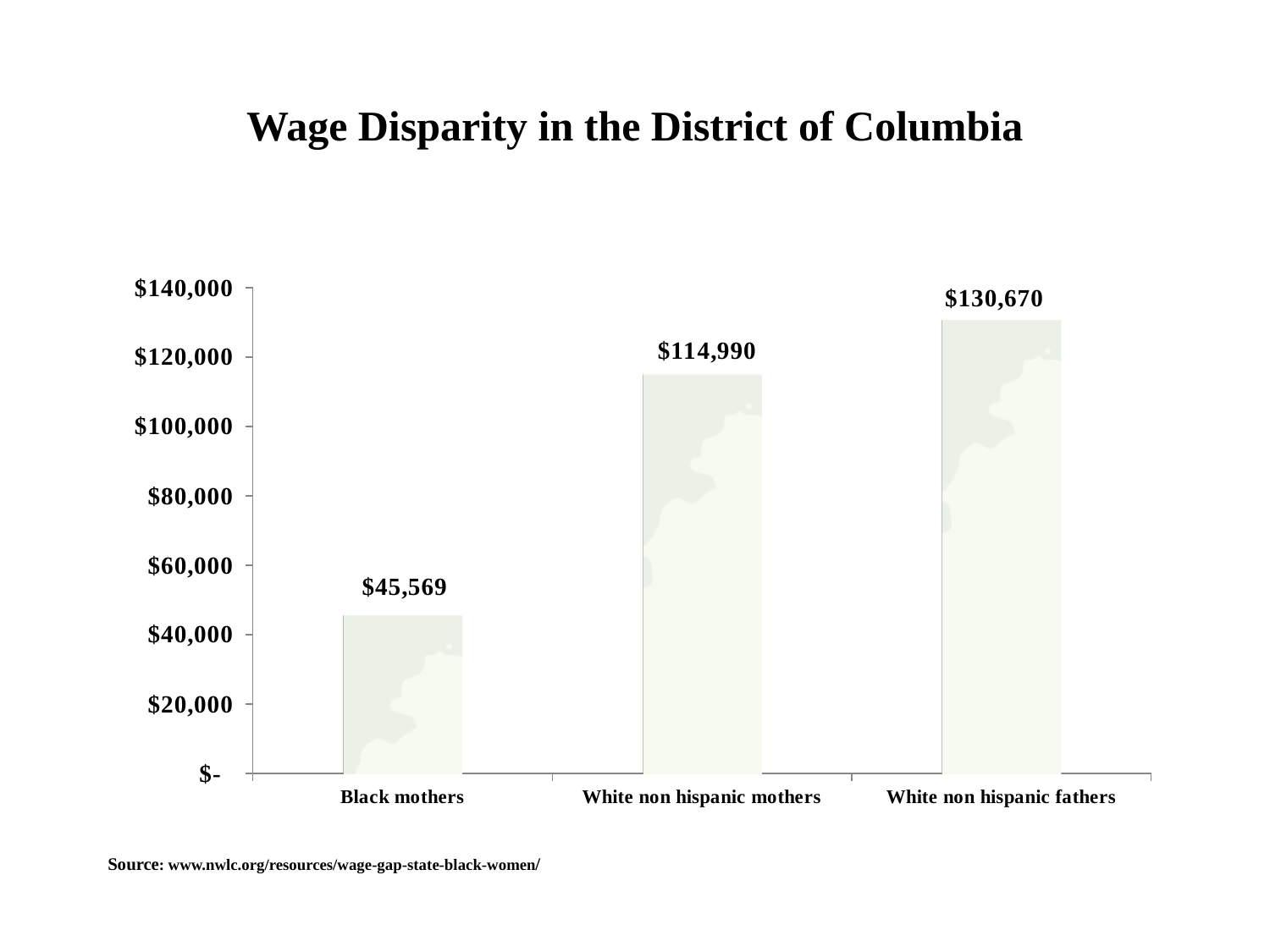
What kind of chart is shown on the slide? bar chart What is the difference between the values for White non hispanic fathers and White non hispanic mothers? $15,680 What is the value for Black mothers? $45,569 Which category has the lowest value? Black mothers Which is larger, the value for Black mothers or the value for White non hispanic mothers? White non hispanic mothers What is the difference between the values for White non hispanic mothers and Black mothers? $69,421 Is the value for Black mothers greater or less than $60,000? less How many categories are shown on the chart? 3 What is the value for White non hispanic mothers? $114,990 What is the title of the chart? Wage Disparity in the District of Columbia What is the value for White non hispanic fathers? $130,670 Which category has the highest value? White non hispanic fathers